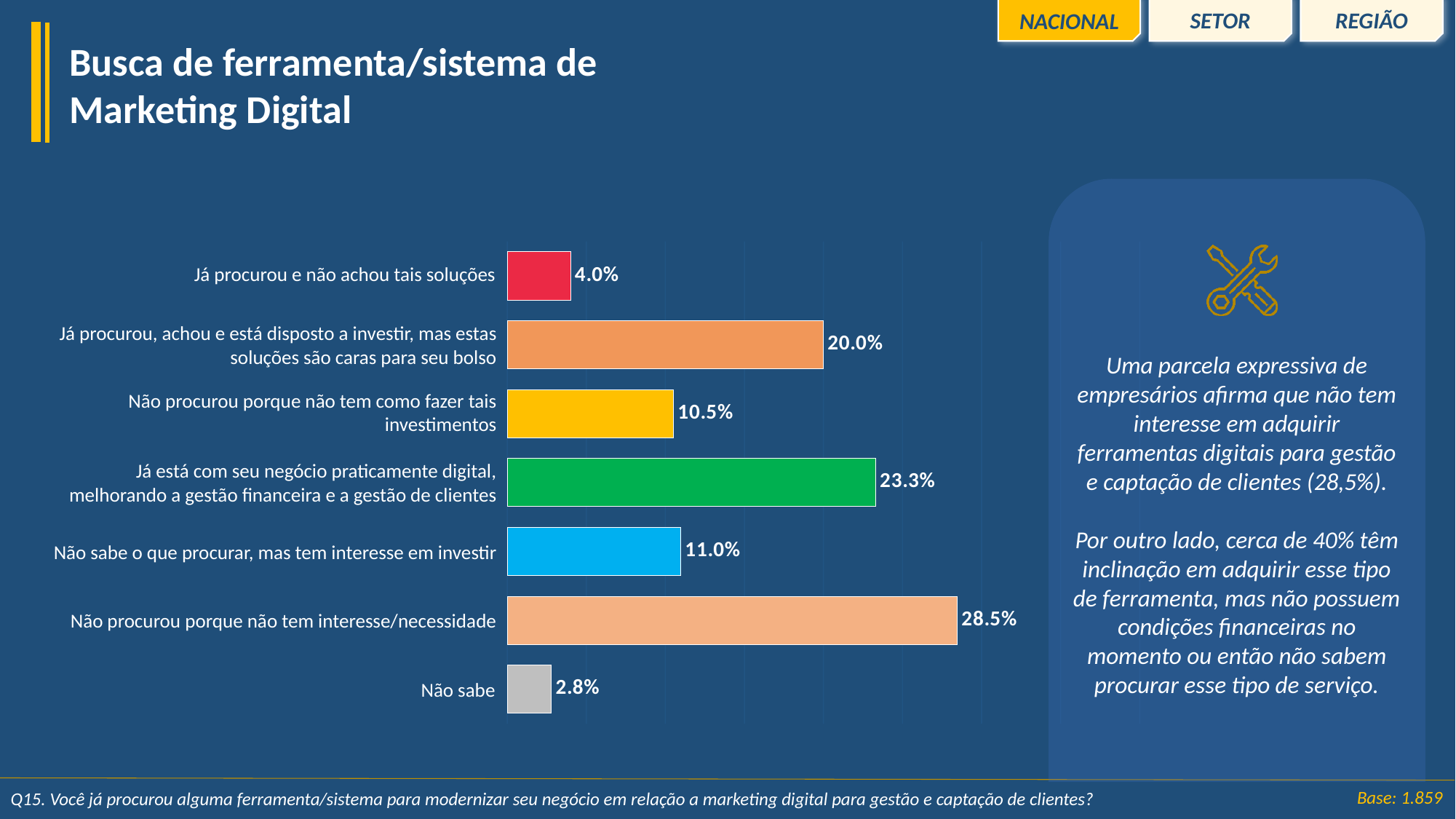
How many categories are shown in the chart? 7 What is the title of the chart on the slide? Busca de ferramenta/sistema de Marketing Digital What colour is the bar for "Não sabe"? Grey What is the value for "Já procurou e não achou tais soluções"? 4.0% Which category has the lowest value? Não sabe What is the value for "Não sabe o que procurar, mas tem interesse em investir"? 11.0% Which is larger: "Não procurou porque não tem como fazer tais investimentos" or "Não sabe o que procurar, mas tem interesse em investir"? Não sabe o que procurar, mas tem interesse em investir What is the difference between "Já procurou e não achou tais soluções" and "Não sabe"? 1.2% What kind of chart is shown on the slide? Bar chart What is the value for "Não procurou porque não tem interesse/necessidade"? 28.5% What is the difference between "Já está com seu negócio praticamente digital, melhorando a gestão financeira e a gestão de clientes" and "Já procurou, achou e está disposto a investir, mas estas soluções são caras para seu bolso"? 3.3% Which category has the highest value? Não procurou porque não tem interesse/necessidade